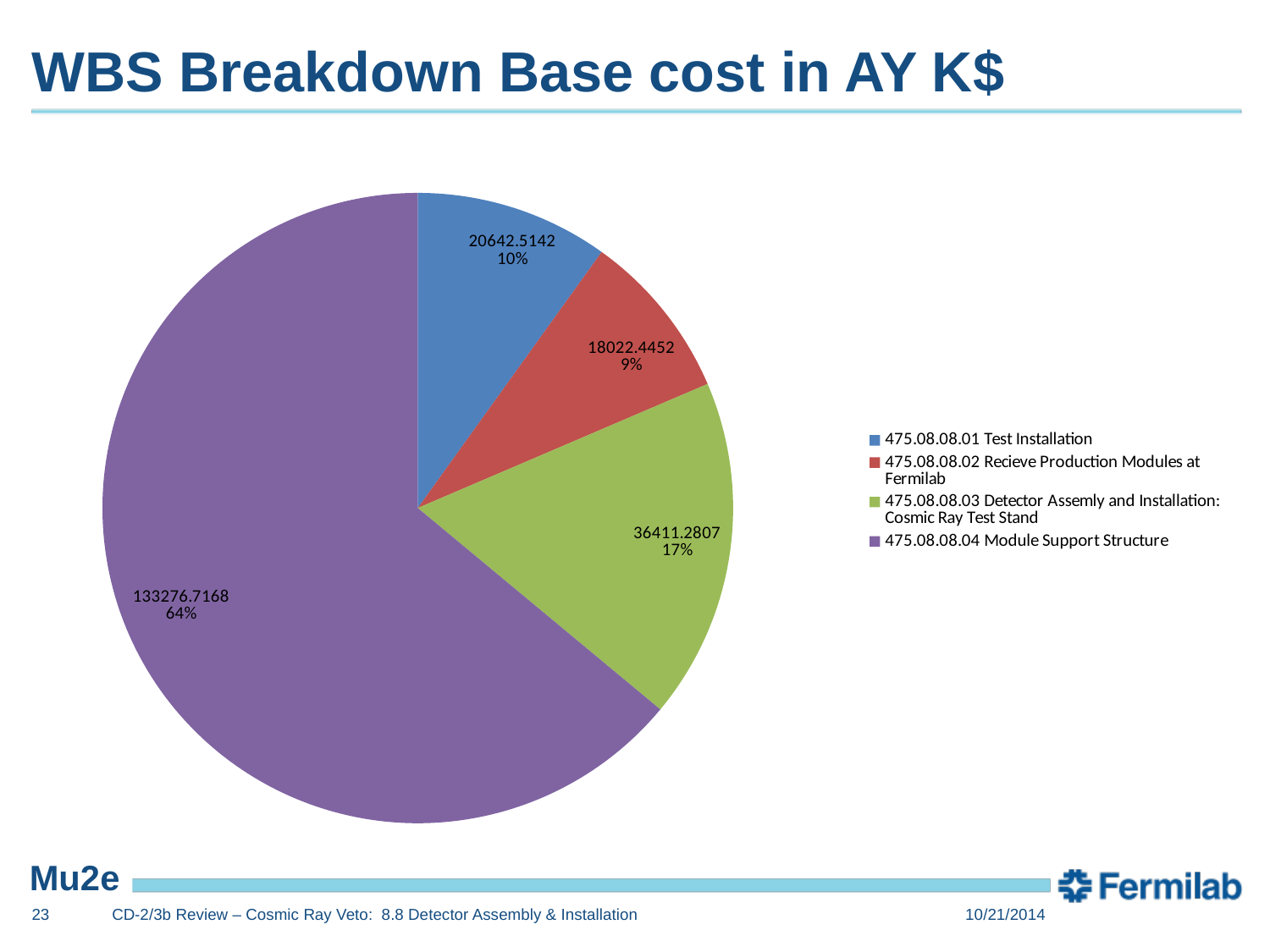
Which category has the smallest slice of the pie? 475.08.08.02 Recieve Production Modules at Fermilab Which is larger, the value for 475.08.08.01 Test Installation or the value for 475.08.08.02 Recieve Production Modules at Fermilab? 475.08.08.01 Test Installation What is the title of the slide containing the pie chart? WBS Breakdown Base cost in AY K$ How many slices does the pie chart have? 4 What type of chart is shown on the slide? Pie chart What is the difference between the values for 475.08.08.03 Detector Assemly and Installation: Cosmic Ray Test Stand and 475.08.08.01 Test Installation? 15768.7665 What is the value for 475.08.08.03 Detector Assemly and Installation: Cosmic Ray Test Stand? 36411.2807 What is the value for 475.08.08.01 Test Installation? 20642.5142 What share of the pie does 475.08.08.04 Module Support Structure represent? 64% What share of the pie does 475.08.08.02 Recieve Production Modules at Fermilab represent? 9% What is the value for 475.08.08.04 Module Support Structure? 133276.7168 Which category has the largest slice of the pie? 475.08.08.04 Module Support Structure